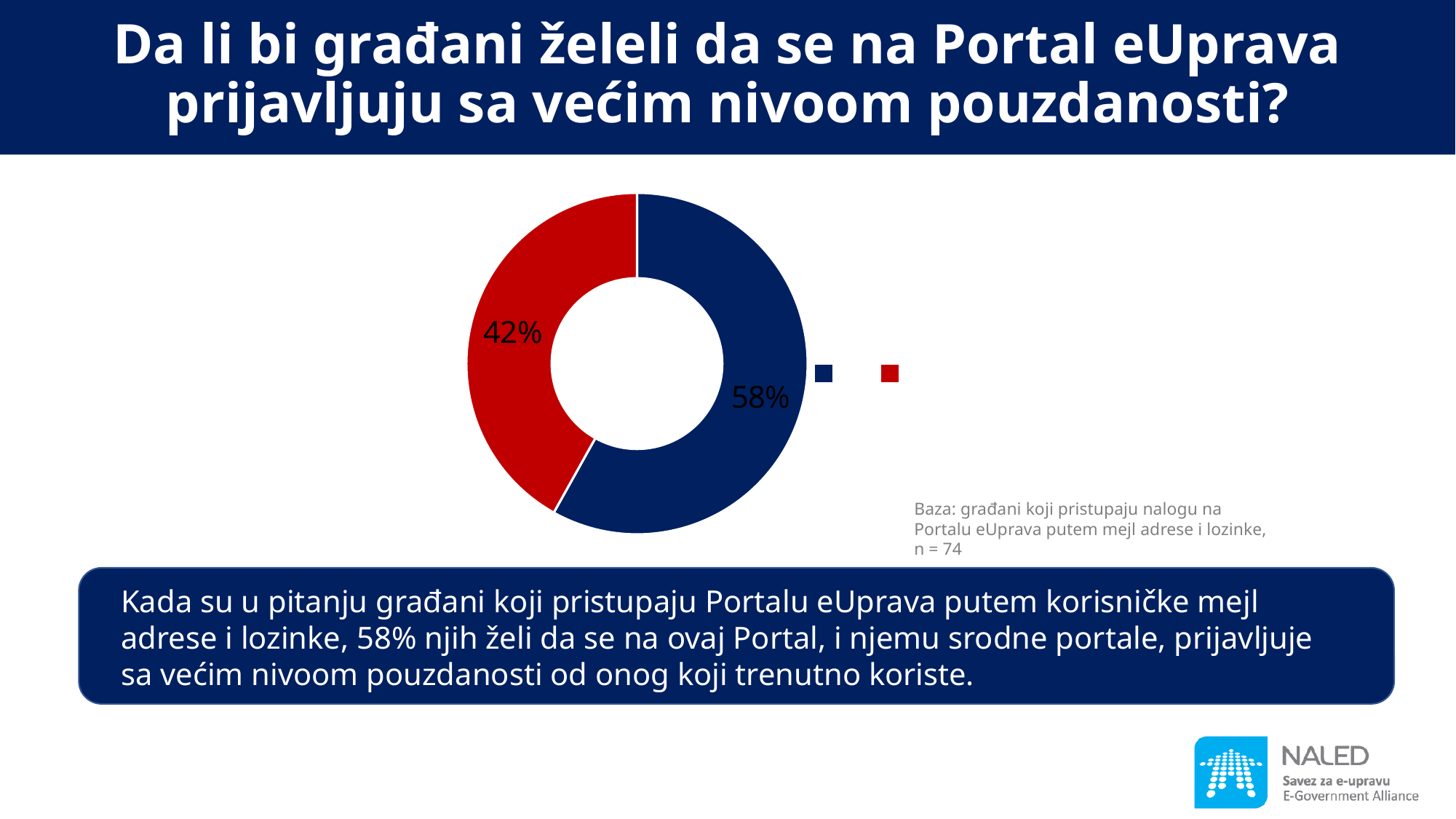
What is the difference in percentage points between the dark blue slice and the red slice? 16 percentage points What percentage is shown on the dark blue slice of the donut chart? 58% Which slice of the donut chart is larger, the dark blue one or the red one? The dark blue one Which slice of the donut chart is the smallest? The red slice (42%) Is the value of the dark blue slice greater or less than 50%? greater How many entries does the legend next to the donut chart show? 2 How many slices does the donut chart have? 2 What percentage is shown on the red slice of the donut chart? 42% What kind of chart is shown on the slide? Donut (pie) chart What sample size (n) is stated in the base note below the chart? n = 74 Which slice of the donut chart is the largest? The dark blue slice (58%) What share of the donut chart does the red slice represent? 42%